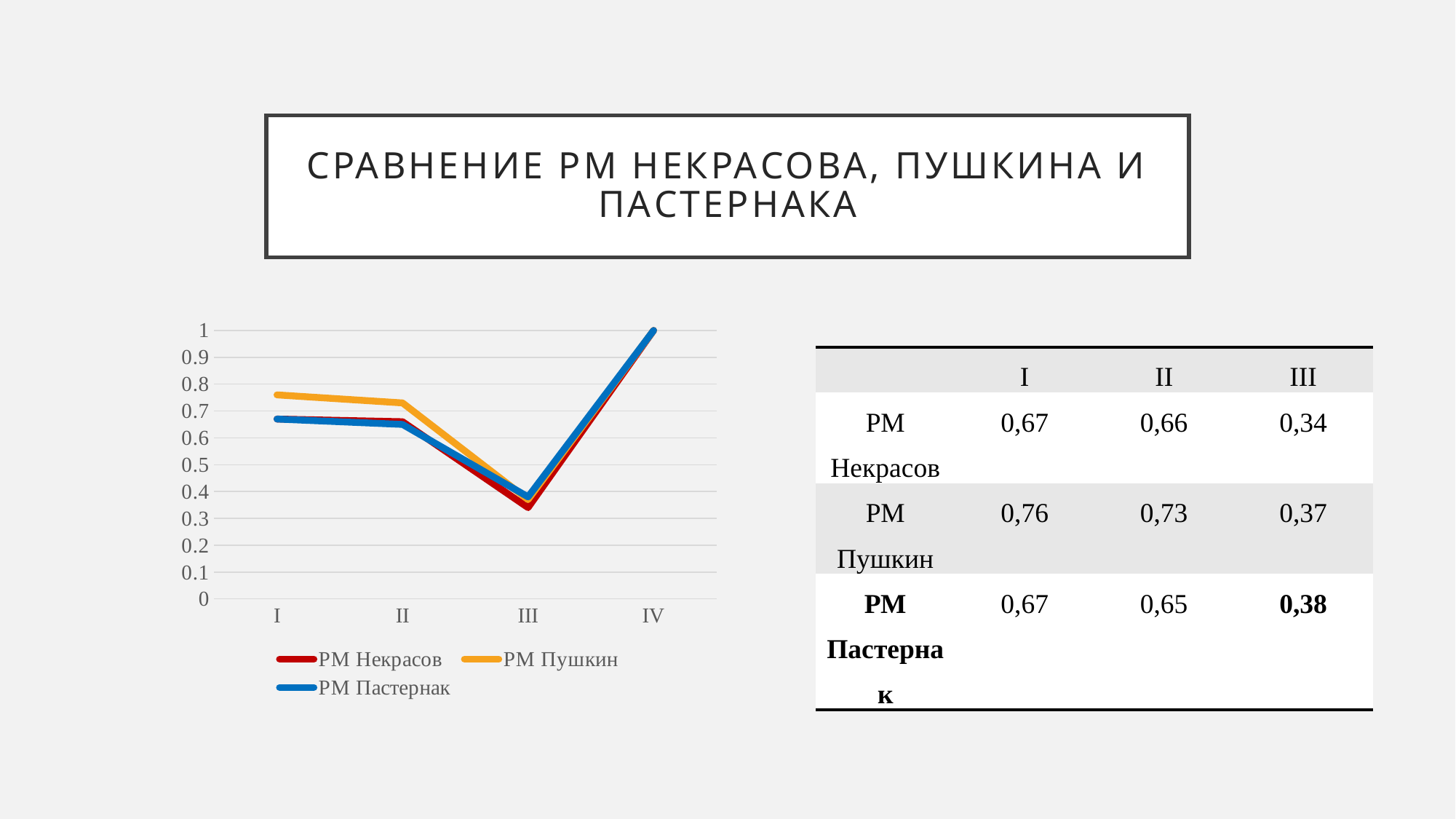
What is the value of РМ Пастернак at category III? 0,38 Is the value for РМ Некрасов at category IV greater or less than 0.5? greater How many series does the chart legend list? 3 What is the value of РМ Пушкин at category I? 0,76 Do the values of РМ Пушкин rise or fall from category II to category III? fall Which series has the highest value at category I? РМ Пушкин What kind of chart is shown on the slide? line chart At category II, which is larger: РМ Пушкин or РМ Пастернак? РМ Пушкин What is the value of РМ Некрасов at category II? 0,66 What is the difference between the values of РМ Пушкин and РМ Некрасов at category I? 0,09 Which series has the lowest value at category III? РМ Некрасов How many categories are shown along the x axis of the chart? 4